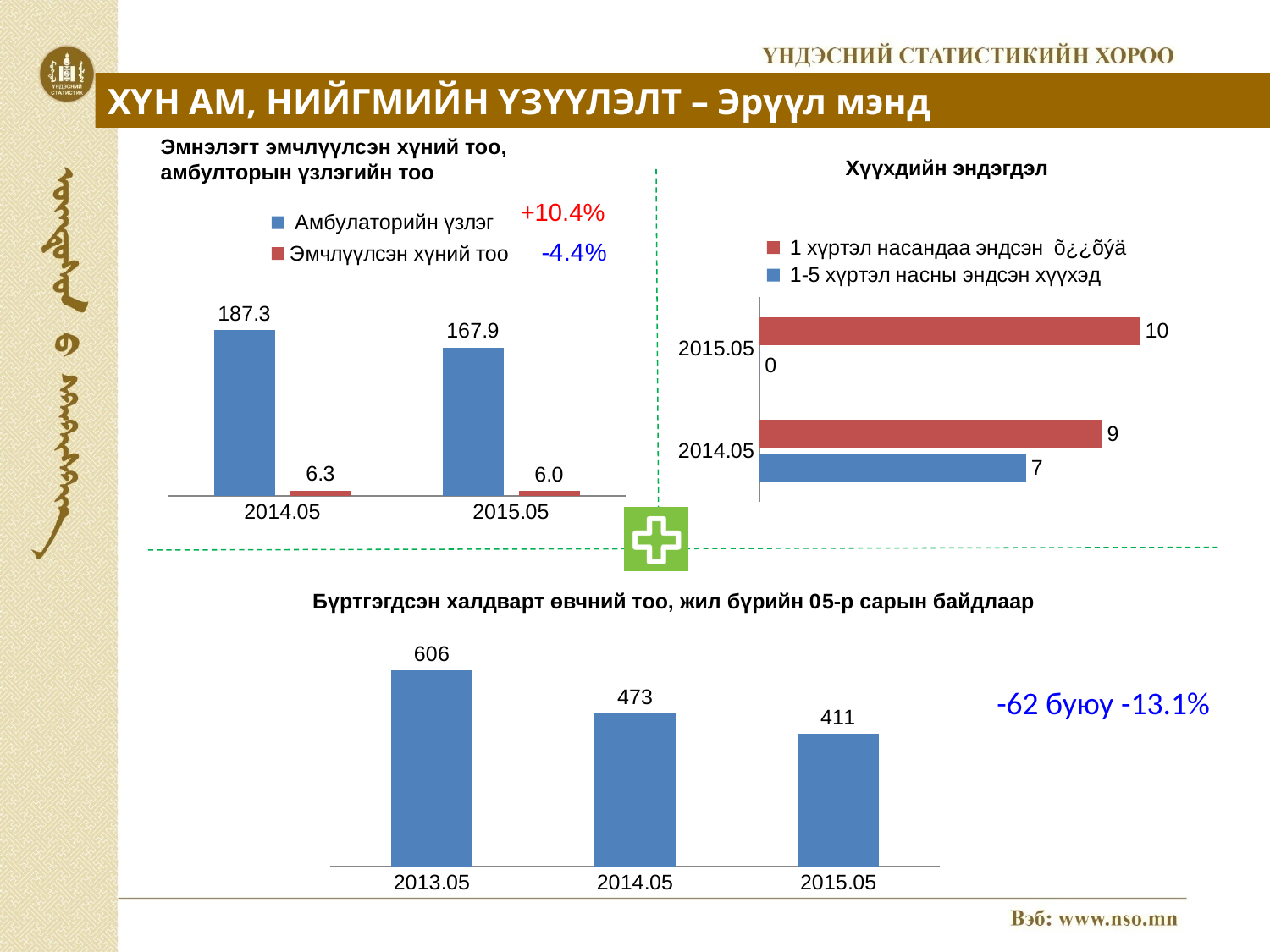
In the bottom chart 'Бүртгэгдсэн халдварт өвчний тоо, жил бүрийн 05-р сарын байдлаар', what is the difference between the values for 2013.05 and 2015.05? 195 What kind of chart is the top-right chart 'Хүүхдийн эндэгдэл'? bar chart How many categories are shown in the bottom chart 'Бүртгэгдсэн халдварт өвчний тоо, жил бүрийн 05-р сарын байдлаар'? 3 In the top-left chart 'Эмнэлэгт эмчлүүлсэн хүний тоо, амбулторын үзлэгийн тоо', which is larger: 'Амбулаторийн үзлэг' for 2014.05 or for 2015.05? 2014.05 In the top-right chart 'Хүүхдийн эндэгдэл', what is the value of '1-5 хүртэл насны эндсэн хүүхэд' for 2014.05? 7 In the top-left chart 'Эмнэлэгт эмчлүүлсэн хүний тоо, амбулторын үзлэгийн тоо', what is the value of 'Эмчлүүлсэн хүний тоо' for 2014.05? 6.3 In the bottom chart 'Бүртгэгдсэн халдварт өвчний тоо, жил бүрийн 05-р сарын байдлаар', do the values rise or fall from 2013.05 to 2015.05? fall In the bottom chart 'Бүртгэгдсэн халдварт өвчний тоо, жил бүрийн 05-р сарын байдлаар', which category has the lowest value? 2015.05 In the bottom chart 'Бүртгэгдсэн халдварт өвчний тоо, жил бүрийн 05-р сарын байдлаар', what is the value for 2013.05? 606 In the top-right chart 'Хүүхдийн эндэгдэл', what is the value of the red series for 2015.05? 10 How many series does the legend list in the top-left chart 'Эмнэлэгт эмчлүүлсэн хүний тоо, амбулторын үзлэгийн тоо'? 2 In the top-left chart 'Эмнэлэгт эмчлүүлсэн хүний тоо, амбулторын үзлэгийн тоо', what is the value of 'Амбулаторийн үзлэг' for 2015.05? 167.9